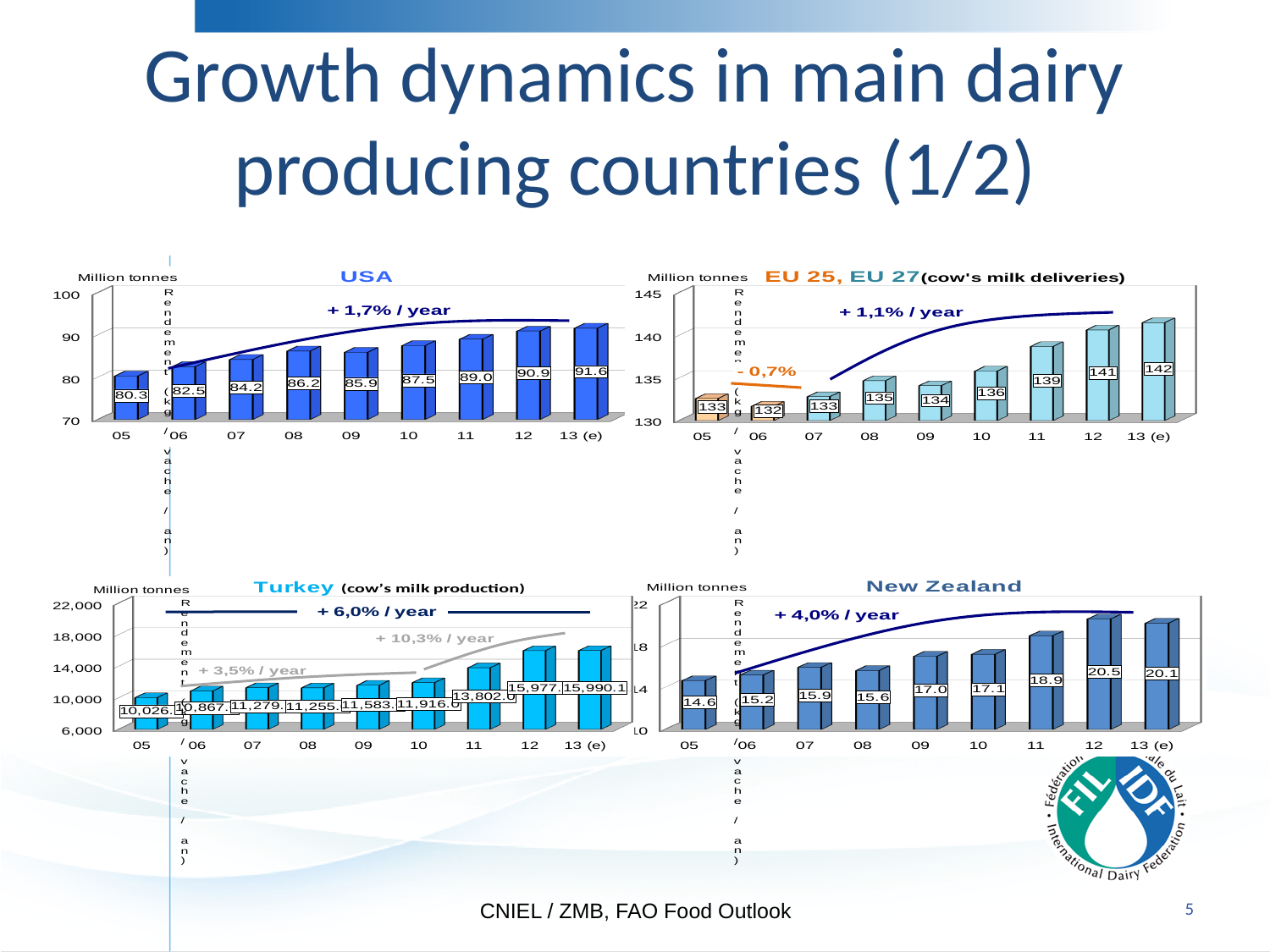
In the New Zealand chart, what is the value for 09? 17.0 In the USA chart, what is the difference between the values for 13 (e) and 05? 11.3 How many years are shown on the x axis of the USA chart? 9 In the New Zealand chart, which year has the highest value? 12 What annual growth rate is annotated on the USA chart? + 1,7% / year In the New Zealand chart, which is larger, the value for 07 or the value for 08? 07 In the USA chart, which year has the highest value? 13 (e) In the USA chart, what is the value for 10? 87.5 In the EU 25, EU 27 chart, what is the difference between the values for 13 (e) and 05? 9 In the EU 25, EU 27 chart, what is the value for 11? 139 In the EU 25, EU 27 chart, which year has the lowest value? 06 In the Turkey chart, is the value for 12 greater or less than 14,000? greater